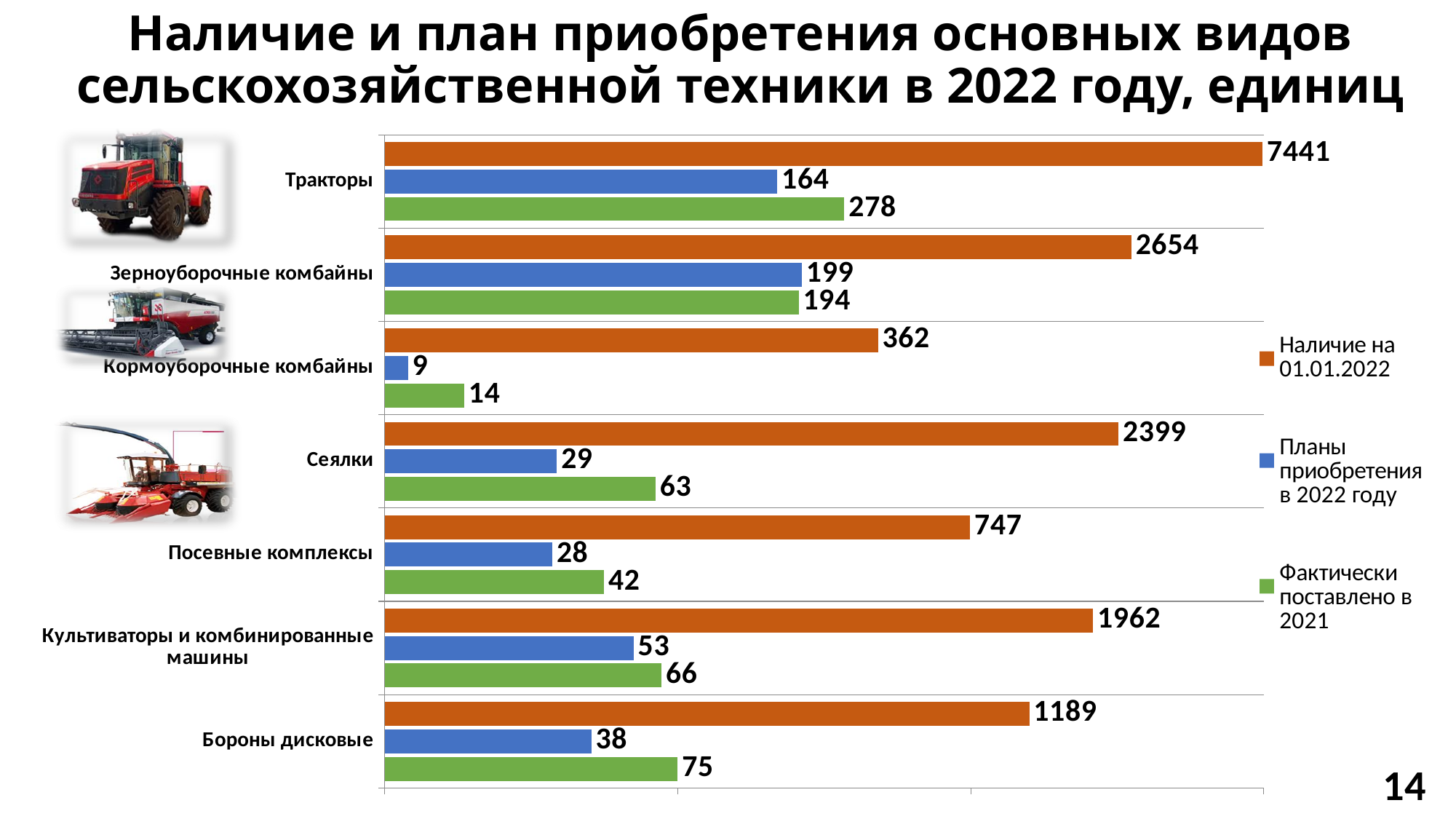
What is the value of "Наличие на 01.01.2022" for Культиваторы и комбинированные машины? 1962 Which category has the highest value for "Наличие на 01.01.2022"? Тракторы What is the value of "Наличие на 01.01.2022" for Тракторы? 7441 Which colour represents the series "Фактически поставлено в 2021"? Green What kind of chart is shown on the slide? Bar chart For Зерноуборочные комбайны, which is larger: "Планы приобретения в 2022 году" or "Фактически поставлено в 2021"? Планы приобретения в 2022 году Which category has the lowest value for "Планы приобретения в 2022 году"? Кормоуборочные комбайны How many categories of equipment are shown on the chart? 7 How many series does the legend list? 3 What is the value of "Фактически поставлено в 2021" for Бороны дисковые? 75 What is the value of "Планы приобретения в 2022 году" for Сеялки? 29 What is the difference between "Фактически поставлено в 2021" and "Планы приобретения в 2022 году" for Тракторы? 114